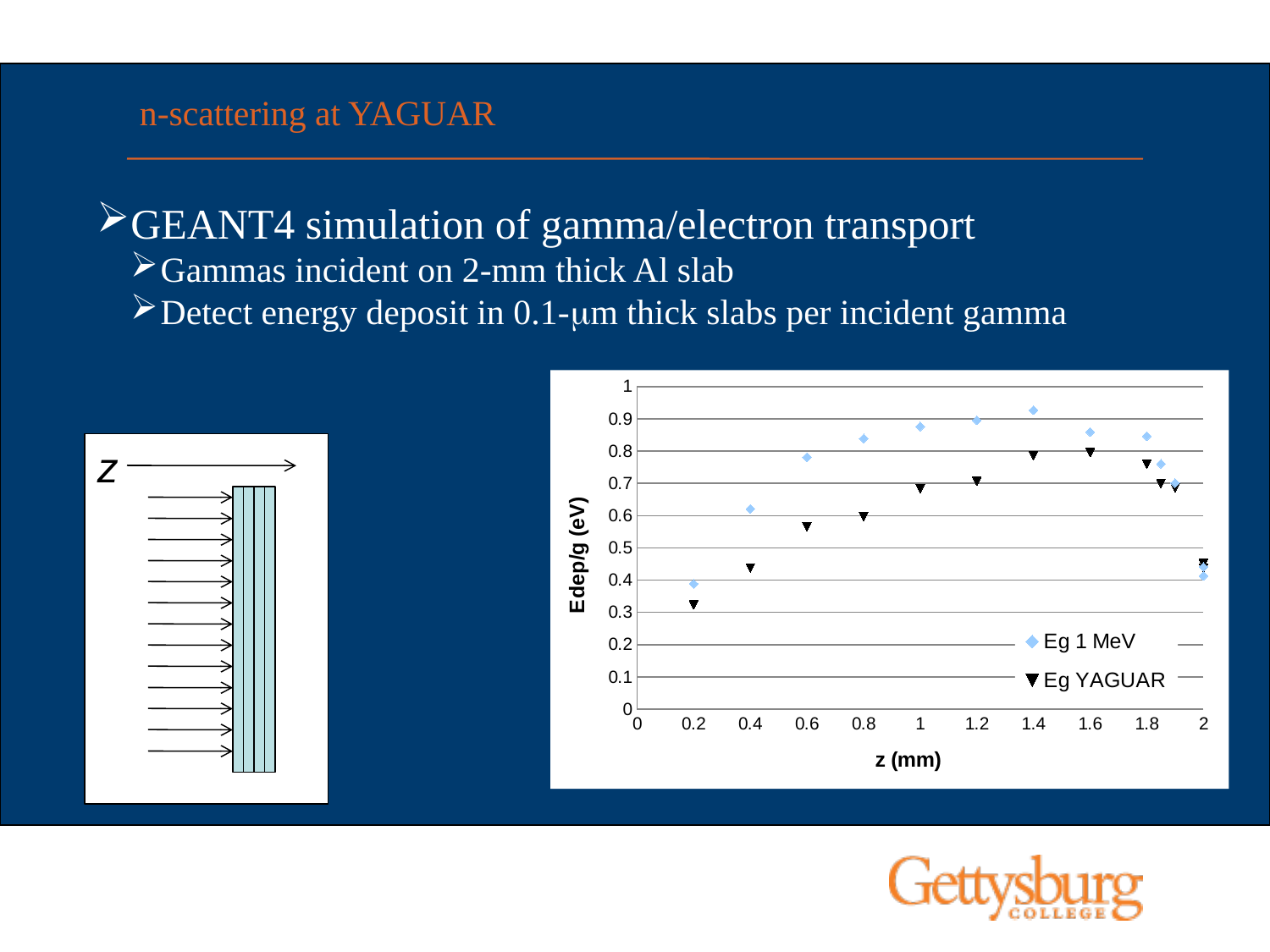
Does the Eg 1 MeV series rise or fall between z = 0.2 and z = 1.4? rise How many series does the chart legend list? 2 Is the Eg YAGUAR value at z = 0.2 greater or less than 0.4? less Is the Eg 1 MeV value at z = 0.6 greater or less than 0.7? greater Is the Eg 1 MeV value at z = 0.2 greater or less than 0.5? less At z = 0.8, which series has the larger Edep/g value, Eg 1 MeV or Eg YAGUAR? Eg 1 MeV What are the two series named in the chart legend? Eg 1 MeV and Eg YAGUAR What kind of chart is shown on the slide? scatter chart At which z value does the Eg 1 MeV series reach its highest point? 1.4 What is the title of the chart's x axis? z (mm)